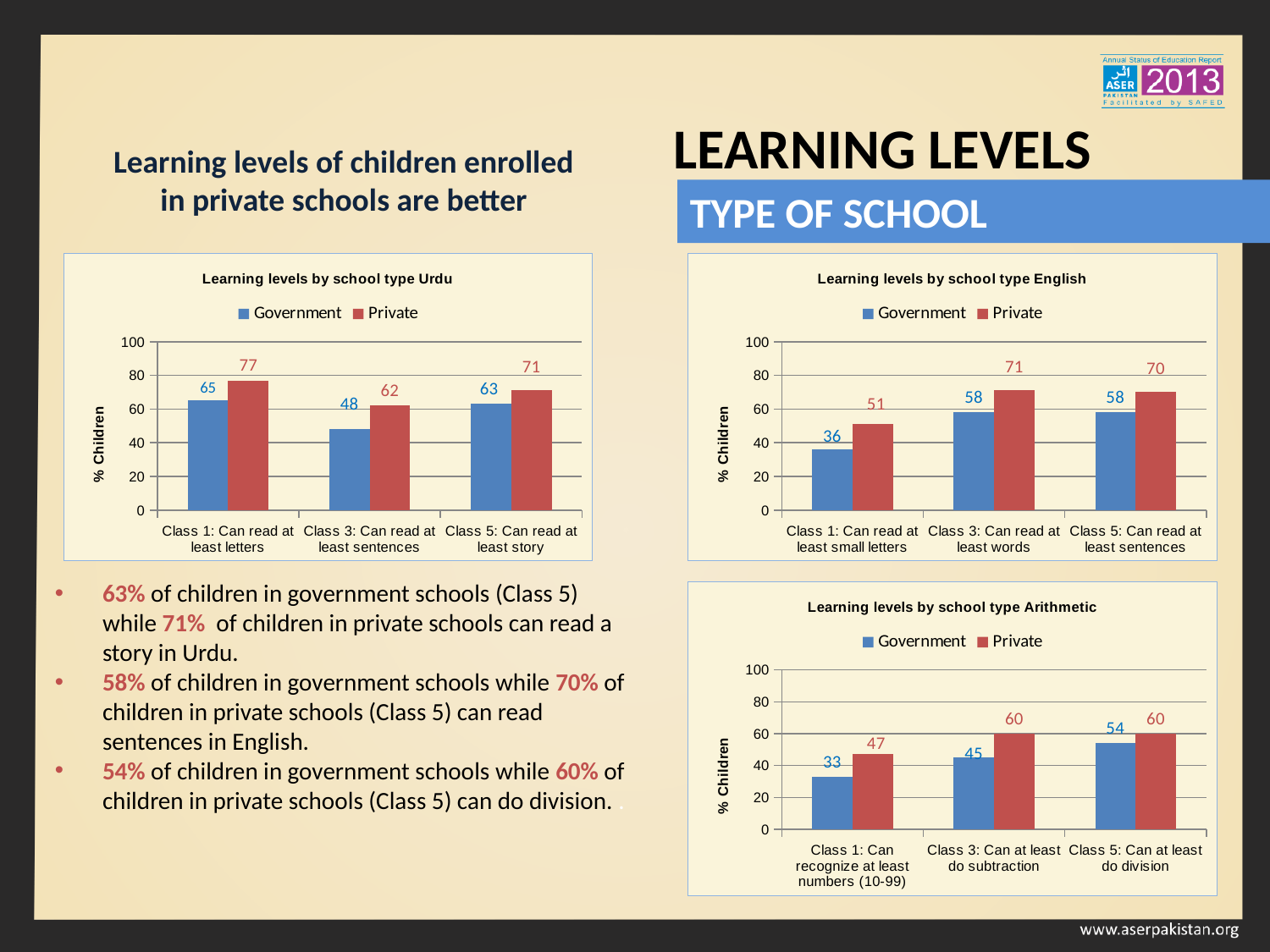
In the 'Learning levels by school type Arithmetic' chart, which is larger for 'Class 3: Can at least do subtraction', Government or Private? Private What type of chart is the 'Learning levels by school type Urdu' chart? Bar chart In the 'Learning levels by school type Urdu' chart, which category has the lowest Government value? Class 3: Can read at least sentences In the 'Learning levels by school type English' chart, what is the difference between Private and Government for 'Class 1: Can read at least small letters'? 15 In the 'Learning levels by school type Arithmetic' chart, what is the value for Government in 'Class 5: Can at least do division'? 54 How many series does the legend of the 'Learning levels by school type Arithmetic' chart list? 2 In the 'Learning levels by school type Arithmetic' chart, what is the difference between Private and Government for 'Class 1: Can recognize at least numbers (10-99)'? 14 In the 'Learning levels by school type English' chart, what is the value for Government in 'Class 1: Can read at least small letters'? 36 How many categories are shown on the x axis of the 'Learning levels by school type English' chart? 3 In the 'Learning levels by school type Urdu' chart, what is the difference between Private and Government for 'Class 3: Can read at least sentences'? 14 In the 'Learning levels by school type Urdu' chart, what is the value for Private in 'Class 1: Can read at least letters'? 77 In the 'Learning levels by school type English' chart, which category has the highest Private value? Class 3: Can read at least words